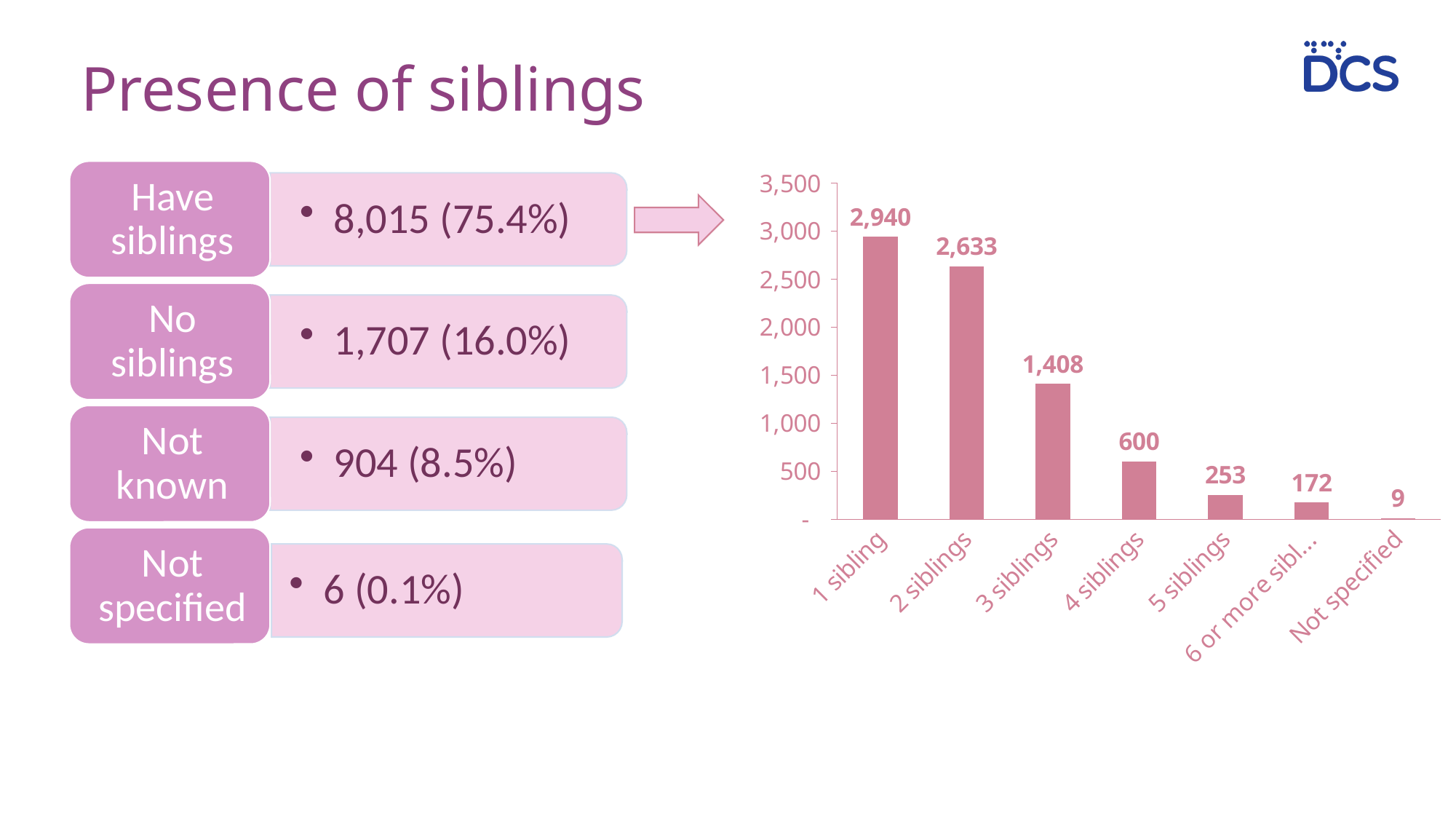
What kind of chart is shown on the slide? bar chart Do the values rise or fall from left to right along the x axis? fall What is the value for 3 siblings? 1,408 Which category has the highest value? 1 sibling What is the value for 1 sibling? 2,940 What is the value for Not specified? 9 How many categories are shown on the x axis of the chart? 7 Which category has the lowest value? Not specified What is the difference between the values for 1 sibling and 2 siblings? 307 What is the difference between the values for 4 siblings and 5 siblings? 347 What is the value for 5 siblings? 253 Which is larger, the value for 3 siblings or the value for 4 siblings? 3 siblings